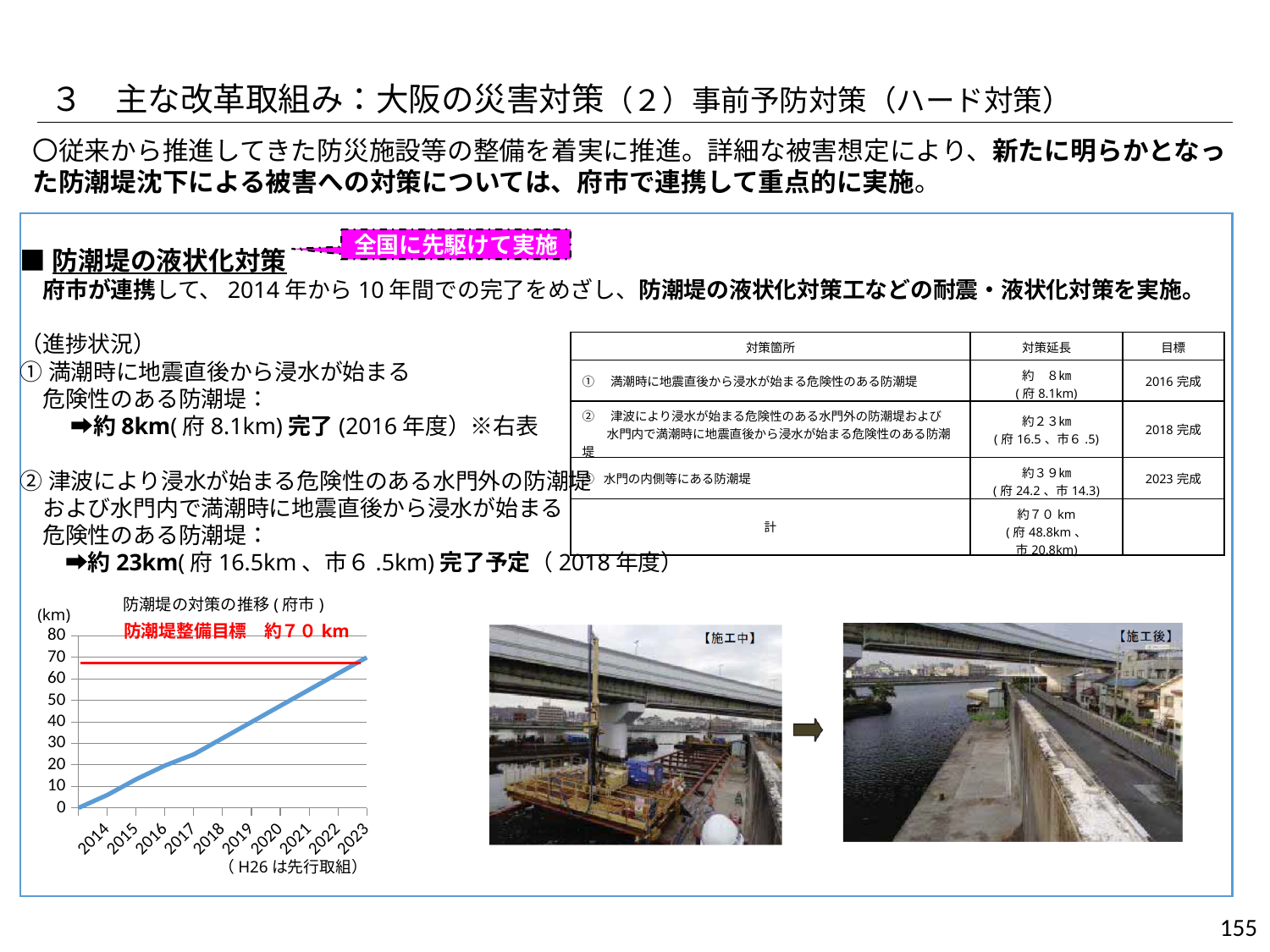
In the chart 防潮堤の対策の推移(府市), which year has the highest value? 2023 In the chart 防潮堤の対策の推移(府市), is the value for 2020 greater or less than 40? greater In the chart 防潮堤の対策の推移(府市), is the value for 2018 greater or less than 40? less What unit is shown on the y axis of the chart 防潮堤の対策の推移(府市)? km What target value does the red horizontal line in the chart 防潮堤の対策の推移(府市) represent? 約70 km In the chart 防潮堤の対策の推移(府市), which is larger, the value for 2022 or the value for 2019? 2022 In the chart 防潮堤の対策の推移(府市), is the value for 2022 greater or less than 50? greater How many years are shown on the x axis of the chart 防潮堤の対策の推移(府市)? 10 In the chart 防潮堤の対策の推移(府市), do the values rise or fall from 2014 to 2023? rise What kind of chart is the chart titled 防潮堤の対策の推移(府市)? line chart In the chart 防潮堤の対策の推移(府市), which year has the lowest value? 2014